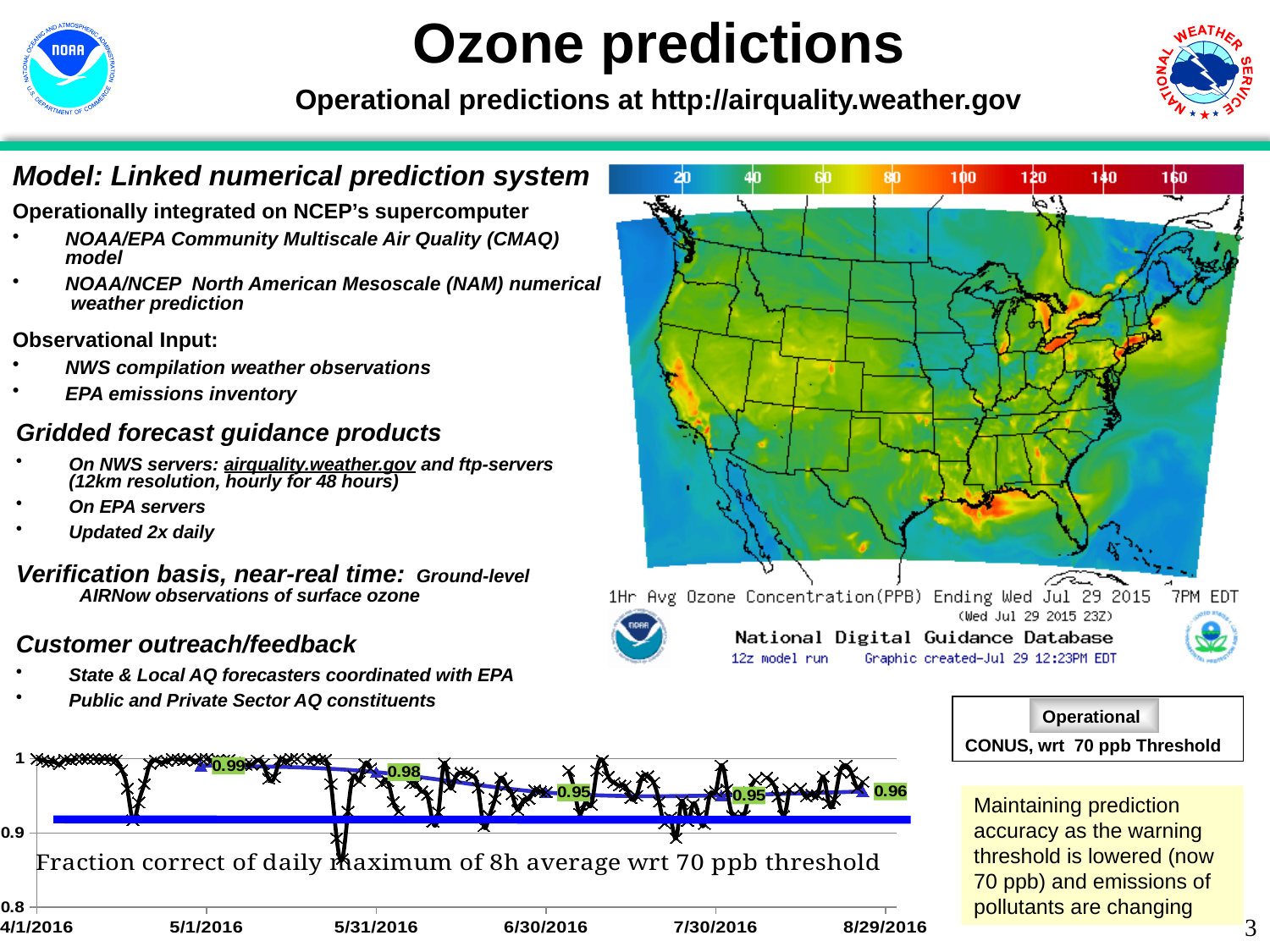
In the line chart at the bottom of the slide, what is the last labeled value on the smoothed trend line, near 8/29/2016? 0.96 In the line chart at the bottom of the slide, is the value at the start of the series on 4/1/2016 greater or less than 0.9? greater In the line chart at the bottom of the slide, what is the first labeled value on the smoothed trend line? 0.99 What kind of chart is shown at the bottom of the slide? line chart In the line chart at the bottom of the slide, which is larger: the labeled value near 5/31/2016 or the labeled value near 8/29/2016? the value near 5/31/2016 (0.98) What is the title text printed inside the line chart at the bottom of the slide? Fraction correct of daily maximum of 8h average wrt 70 ppb threshold In the line chart at the bottom of the slide, what is the lowest labeled value? 0.95 In the line chart at the bottom of the slide, how many data labels are printed on the trend line? 5 In the line chart at the bottom of the slide, what is the difference between the first labeled value (0.99) and the last labeled value (0.96)? 0.03 In the line chart at the bottom of the slide, do the labeled trend-line values generally rise or fall from April to August 2016? fall In the line chart at the bottom of the slide, what is the second labeled value on the trend line, near 5/31/2016? 0.98 In the line chart at the bottom of the slide, what is the highest labeled value? 0.99